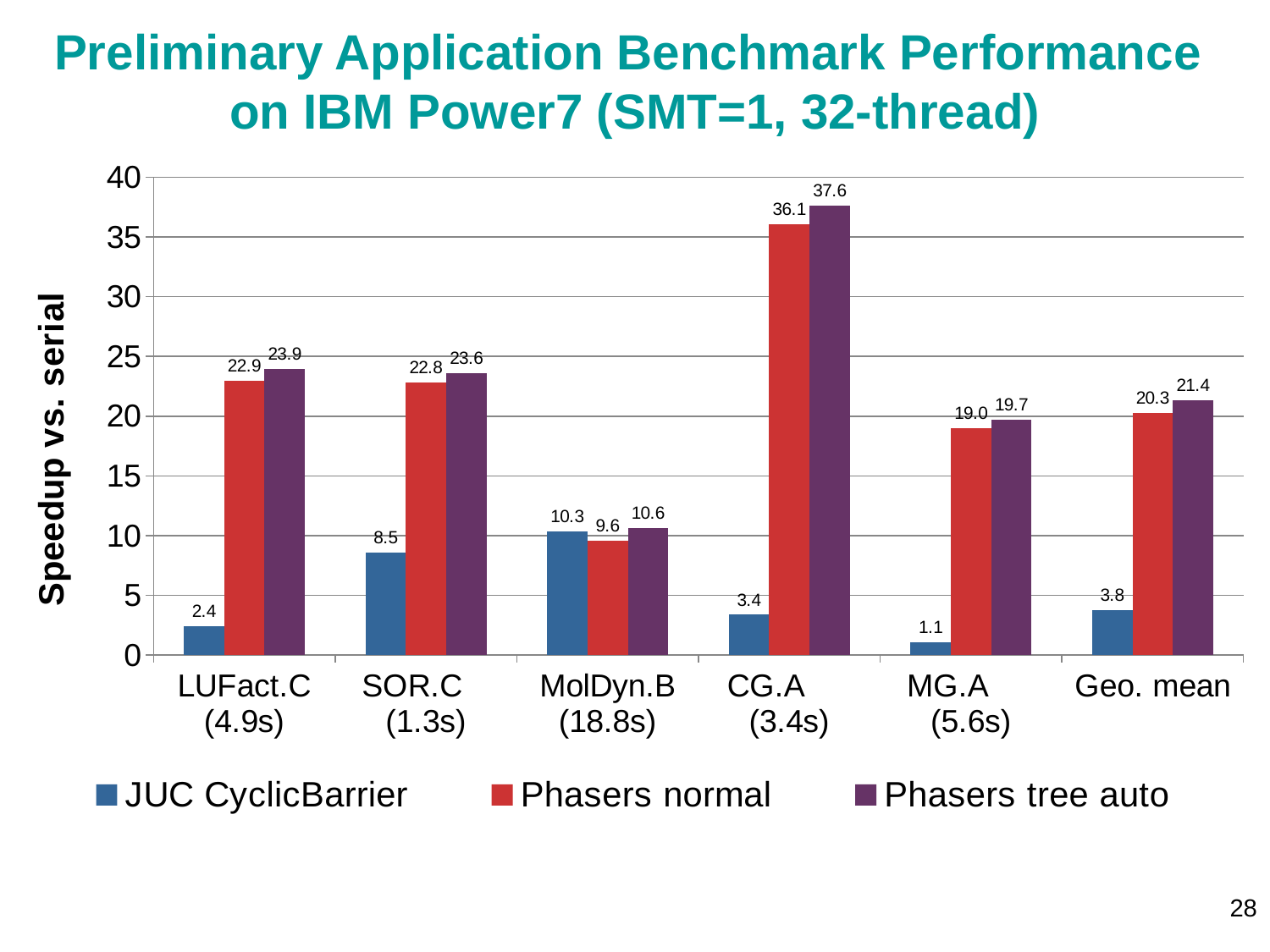
Is the Phasers normal speedup on SOR.C greater or less than 20? greater What kind of chart is shown on the slide? Bar chart What is the label of the y axis? Speedup vs. serial What is the difference between the Phasers tree auto and JUC CyclicBarrier speedups on LUFact.C? 21.5 What is the Geo. mean speedup for Phasers normal? 20.3 What is the speedup for JUC CyclicBarrier on MG.A? 1.1 What is the speedup for Phasers tree auto on CG.A? 37.6 On MolDyn.B, which is larger: the JUC CyclicBarrier speedup or the Phasers normal speedup? JUC CyclicBarrier How many categories are shown on the x axis? 6 Which benchmark has the lowest JUC CyclicBarrier speedup? MG.A How many series does the legend list? 3 Which benchmark has the highest Phasers normal speedup? CG.A